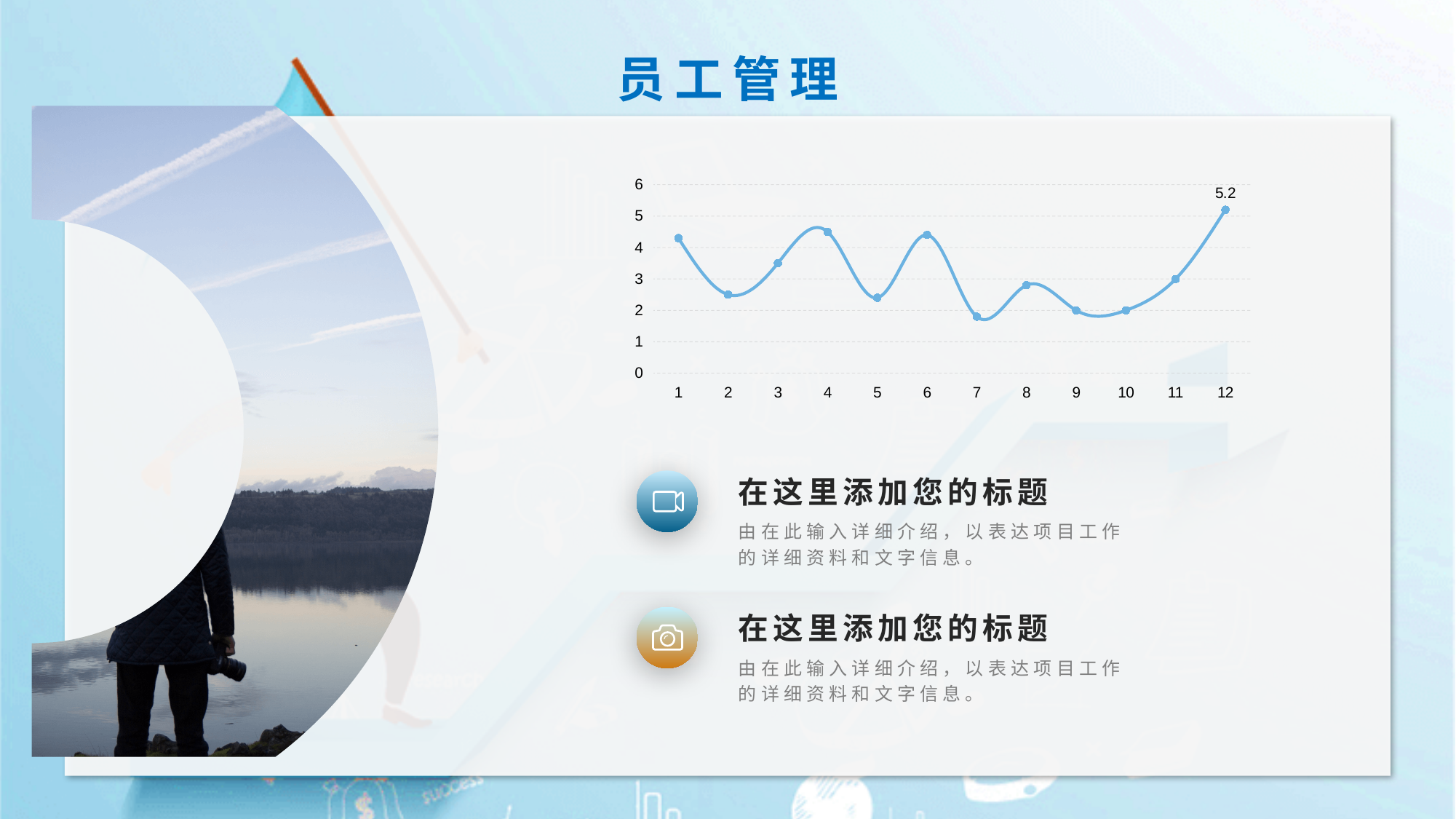
Is the value at x = 1 greater or less than 4? greater Which has the larger value on the line chart, x = 6 or x = 7? 6 Is the value at x = 4 greater or less than 4? greater Is the value at x = 7 greater or less than 2? less How many data points are plotted on the line chart? 12 What is the highest value shown on the y axis of the line chart? 6 What is the value at x = 12 on the line chart? 5.2 Do the values rise or fall from x = 10 to x = 12? rise Which has the larger value on the line chart, x = 4 or x = 5? 4 What kind of chart is shown on the slide? line chart At which x value does the line chart reach its highest point? 12